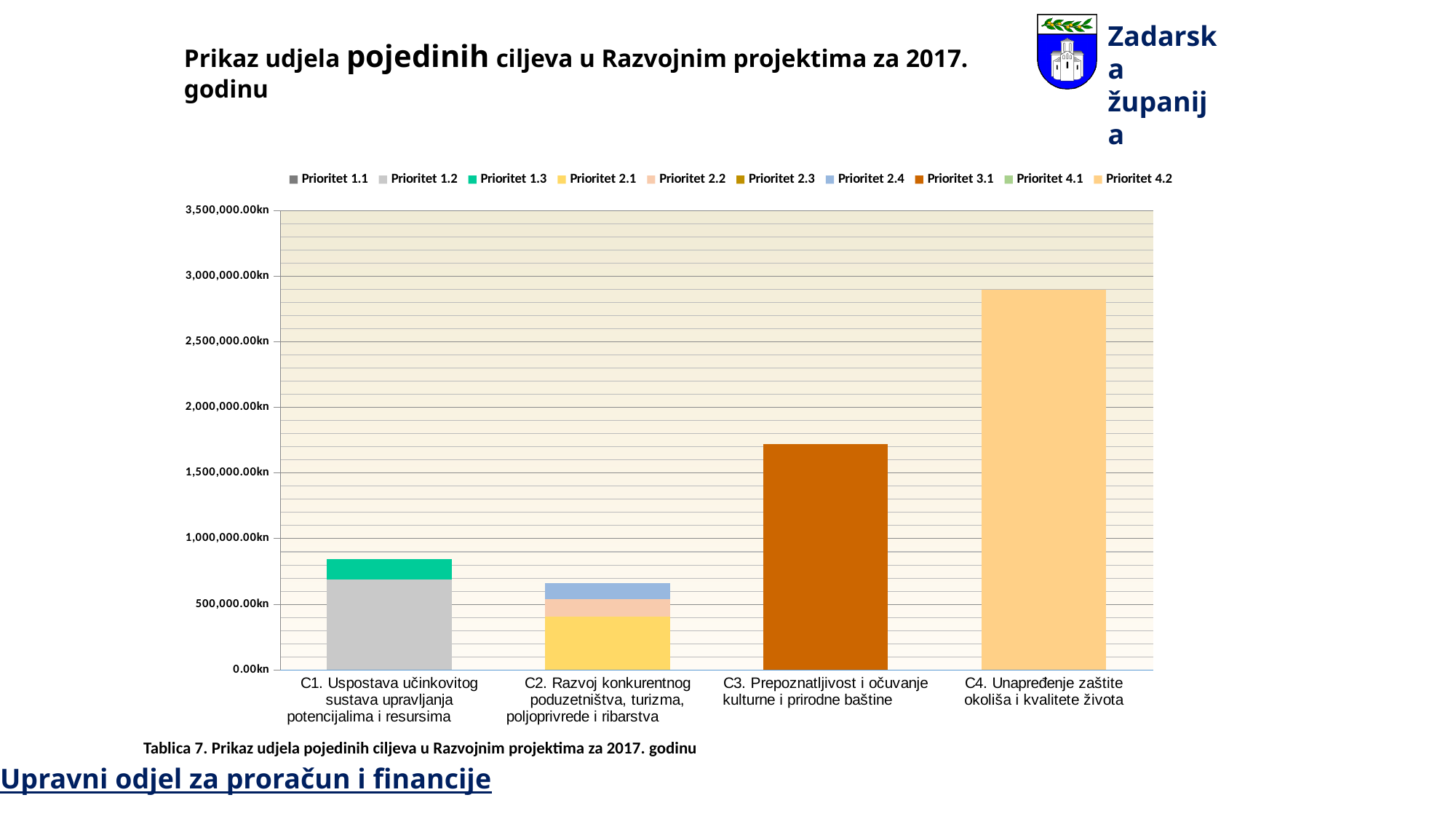
Which category has the shortest bar in the chart? C2. Razvoj konkurentnog poduzetništva, turizma, poljoprivrede i ribarstva Is the value for C3. Prepoznatljivost i očuvanje kulturne i prirodne baštine greater or less than 1,500,000.00kn? greater How many series does the chart's legend list? 10 Which bar is taller: C1. Uspostava učinkovitog sustava upravljanja potencijalima i resursima or C2. Razvoj konkurentnog poduzetništva, turizma, poljoprivrede i ribarstva? C1. Uspostava učinkovitog sustava upravljanja potencijalima i resursima What kind of chart is shown on the slide? Stacked bar chart Is the total value for C1. Uspostava učinkovitog sustava upravljanja potencijalima i resursima greater or less than 1,000,000.00kn? less How many categories (ciljevi) are shown on the x axis of the chart? 4 Which bar is taller: C3. Prepoznatljivost i očuvanje kulturne i prirodne baštine or C4. Unapređenje zaštite okoliša i kvalitete života? C4. Unapređenje zaštite okoliša i kvalitete života Is the total value for C4. Unapređenje zaštite okoliša i kvalitete života greater or less than 2,500,000.00kn? greater What is the title of the chart on the slide? Prikaz udjela pojedinih ciljeva u Razvojnim projektima za 2017. godinu Which category has the tallest bar in the chart? C4. Unapređenje zaštite okoliša i kvalitete života